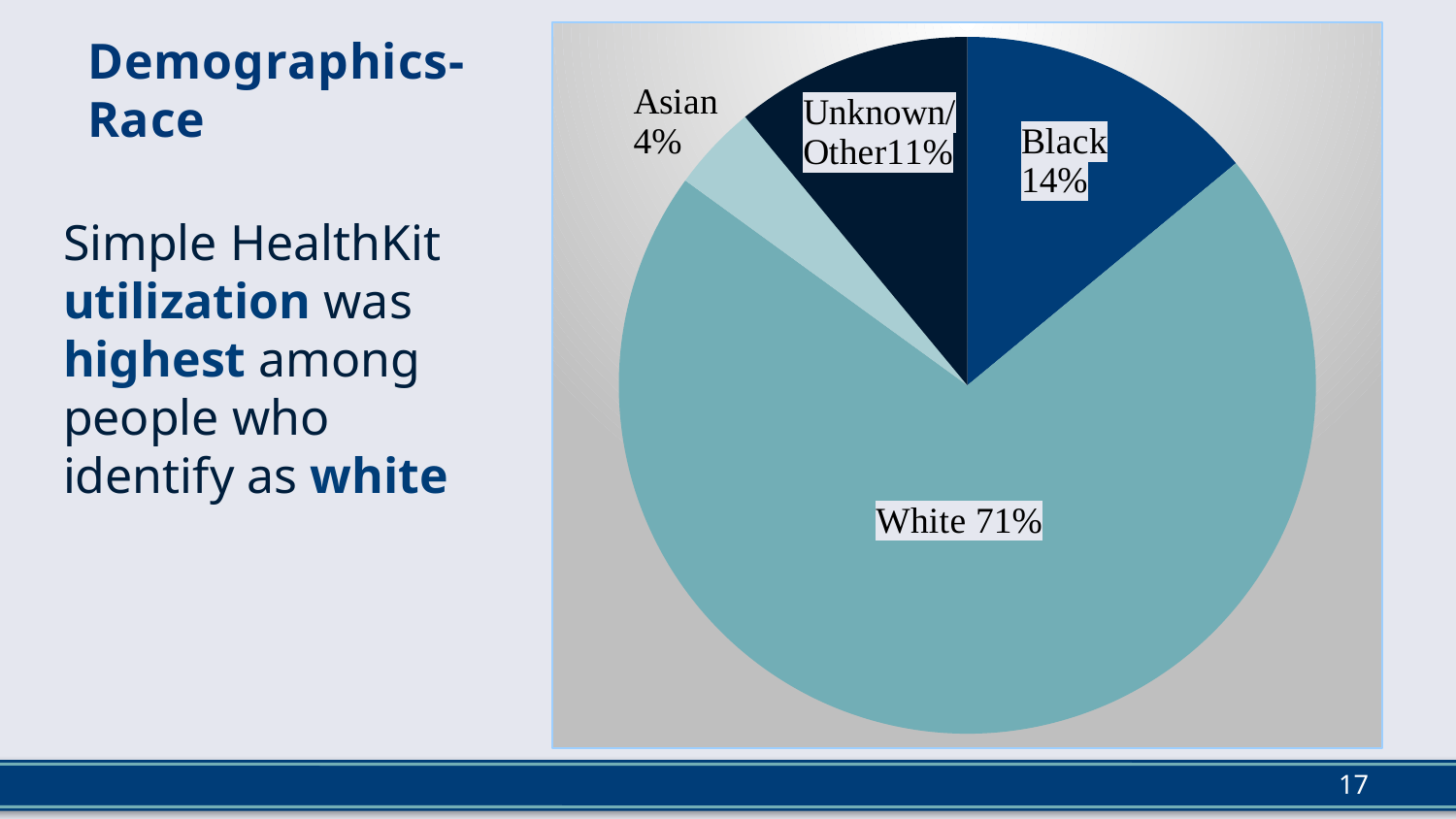
How many slices does the pie chart have? 4 What percentage does the Black slice show? 14% What is the difference in percentage points between the Black and Unknown/Other slices? 3 Which race category has the largest slice of the pie? White What is the combined share of the Asian and Unknown/Other slices? 15% Which race category has the smallest slice of the pie? Asian Which slice is larger, Black or Unknown/Other? Black What percentage is shown for the Asian slice? 4% What is the difference in percentage points between the White and Black slices? 57 What kind of chart is shown on the slide? Pie chart What share of the pie chart is labelled White? 71% What percentage is shown for the Unknown/Other slice? 11%